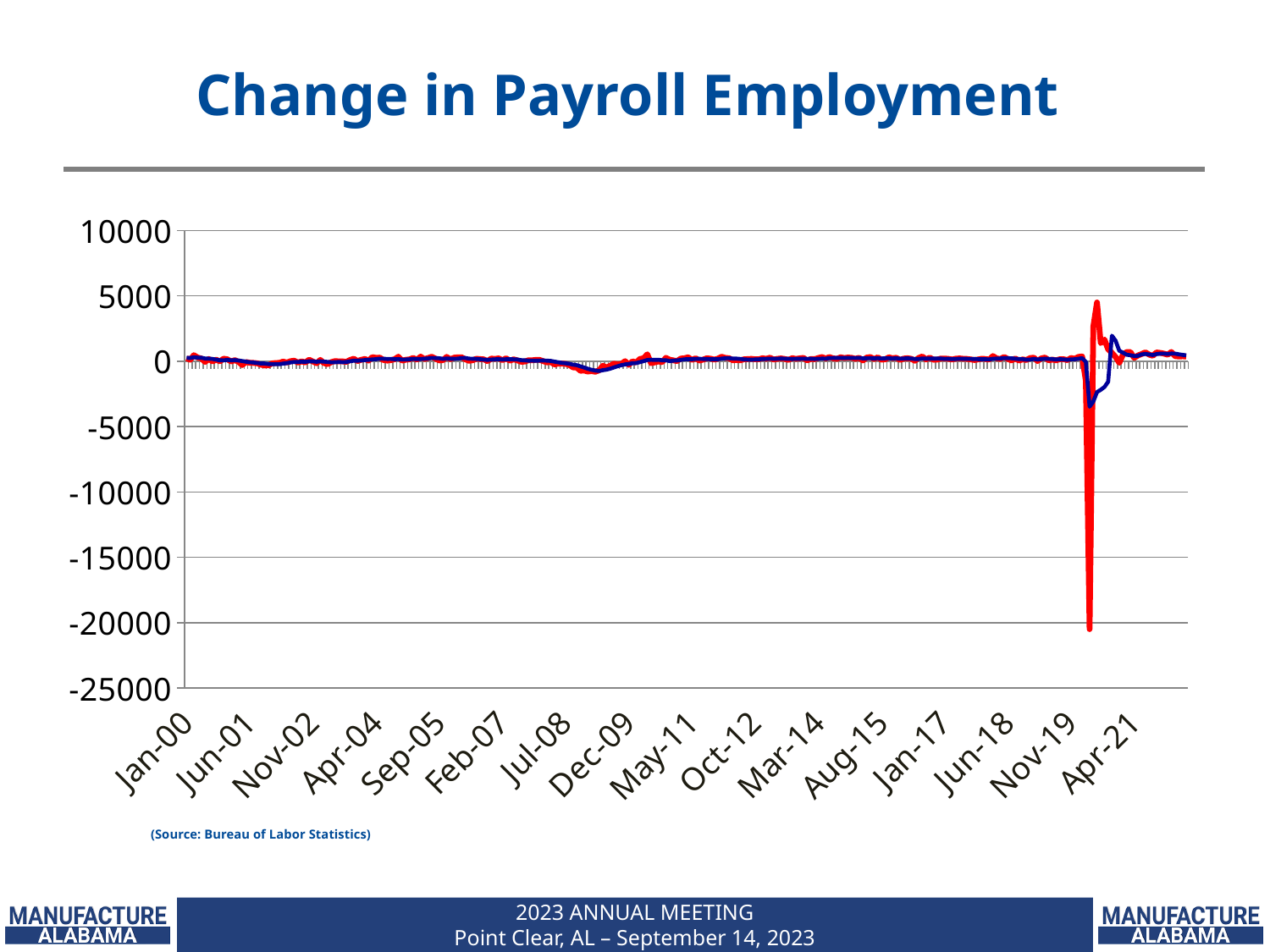
Is the lowest value of the red line greater or less than -15000? less What is the title of the chart? Change in Payroll Employment What is the last date label on the horizontal axis? Apr-21 What is the highest value shown on the vertical axis? 10000 Is the lowest value of the blue line greater or less than -5000? greater What kind of chart is shown on the slide? line chart Which line, red or blue, reaches the lowest value on the chart? red How many date labels are shown along the horizontal axis? 16 What is the lowest value shown on the vertical axis? -25000 What is the first date label on the horizontal axis? Jan-00 How many lines (series) are plotted on the chart? 2 Is the highest value of the red line greater or less than 0? greater